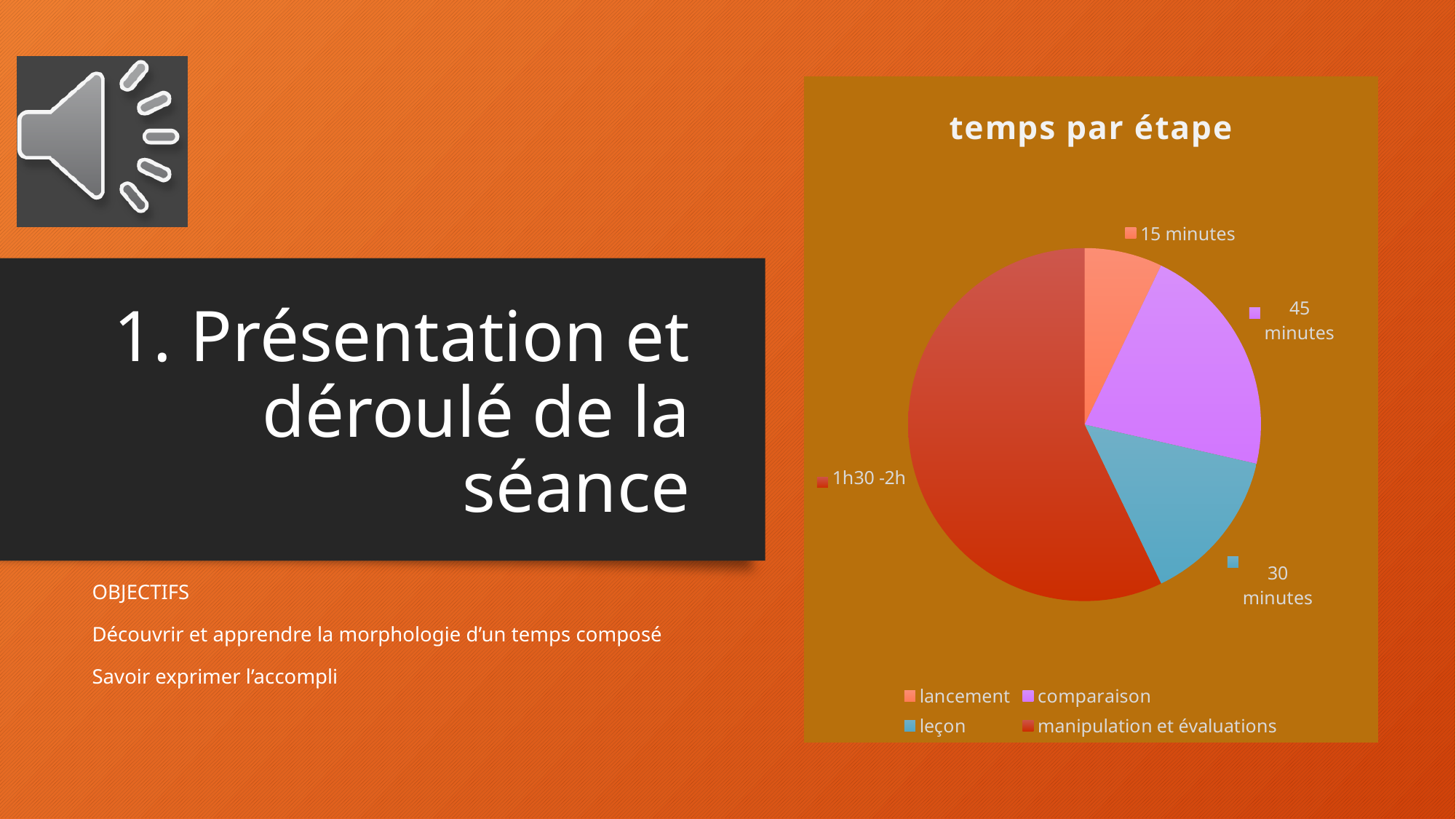
What is the data label shown for the 'comparaison' slice? 45 minutes What is the data label shown for the 'leçon' slice? 30 minutes What type of chart is shown on the slide? pie chart What is the data label shown for the 'lancement' slice? 15 minutes What is the data label shown for the 'manipulation et évaluations' slice? 1h30 -2h Which slice is larger, 'comparaison' or 'leçon'? comparaison Which legend entry is shown in blue? leçon What is the title of the chart? temps par étape How many entries does the chart legend list? 4 How many slices does the pie chart have? 4 Which category takes up the largest share of the pie chart? manipulation et évaluations Which category takes up the smallest share of the pie chart? lancement